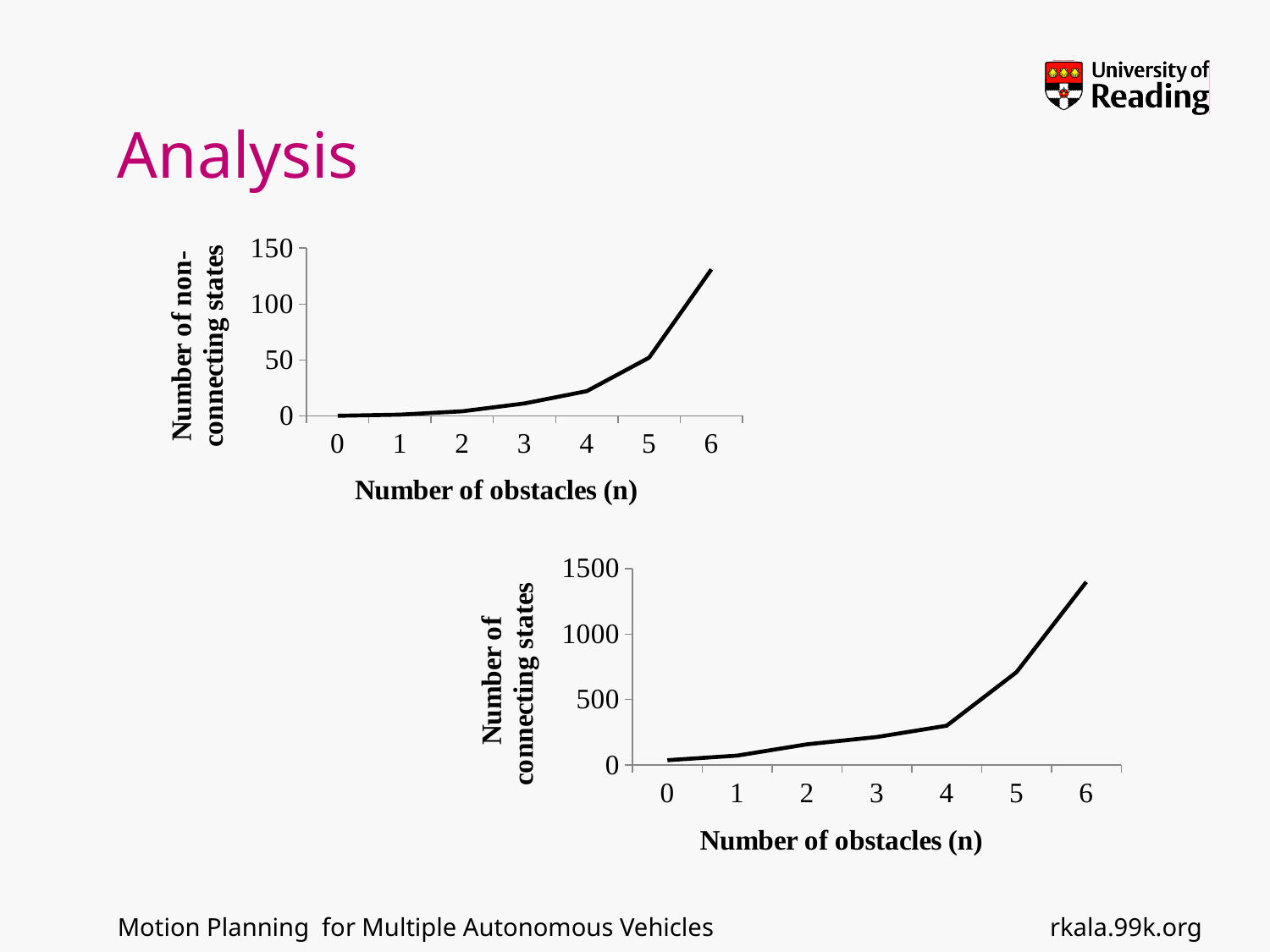
What kind of chart is the bottom chart, with y-axis 'Number of connecting states'? line chart In the bottom chart (connecting states), how many x-axis categories are shown? 7 In the bottom chart (connecting states), do the values rise or fall as the number of obstacles increases? rise In the bottom chart (connecting states), at which number of obstacles is the value lowest? 0 What is the x-axis label of the top chart? Number of obstacles (n) In the top chart (non-connecting states), is the value at 6 obstacles greater or less than 100? greater In the top chart (non-connecting states), at which number of obstacles is the value highest? 6 In the top chart (non-connecting states), do the values rise or fall as the number of obstacles increases? rise In the bottom chart (connecting states), is the value at 4 obstacles greater or less than 500? less In the bottom chart (connecting states), is the value at 6 obstacles greater or less than 1000? greater In the top chart (non-connecting states), how many x-axis categories are shown? 7 What kind of chart is the top chart, with y-axis 'Number of non-connecting states'? line chart